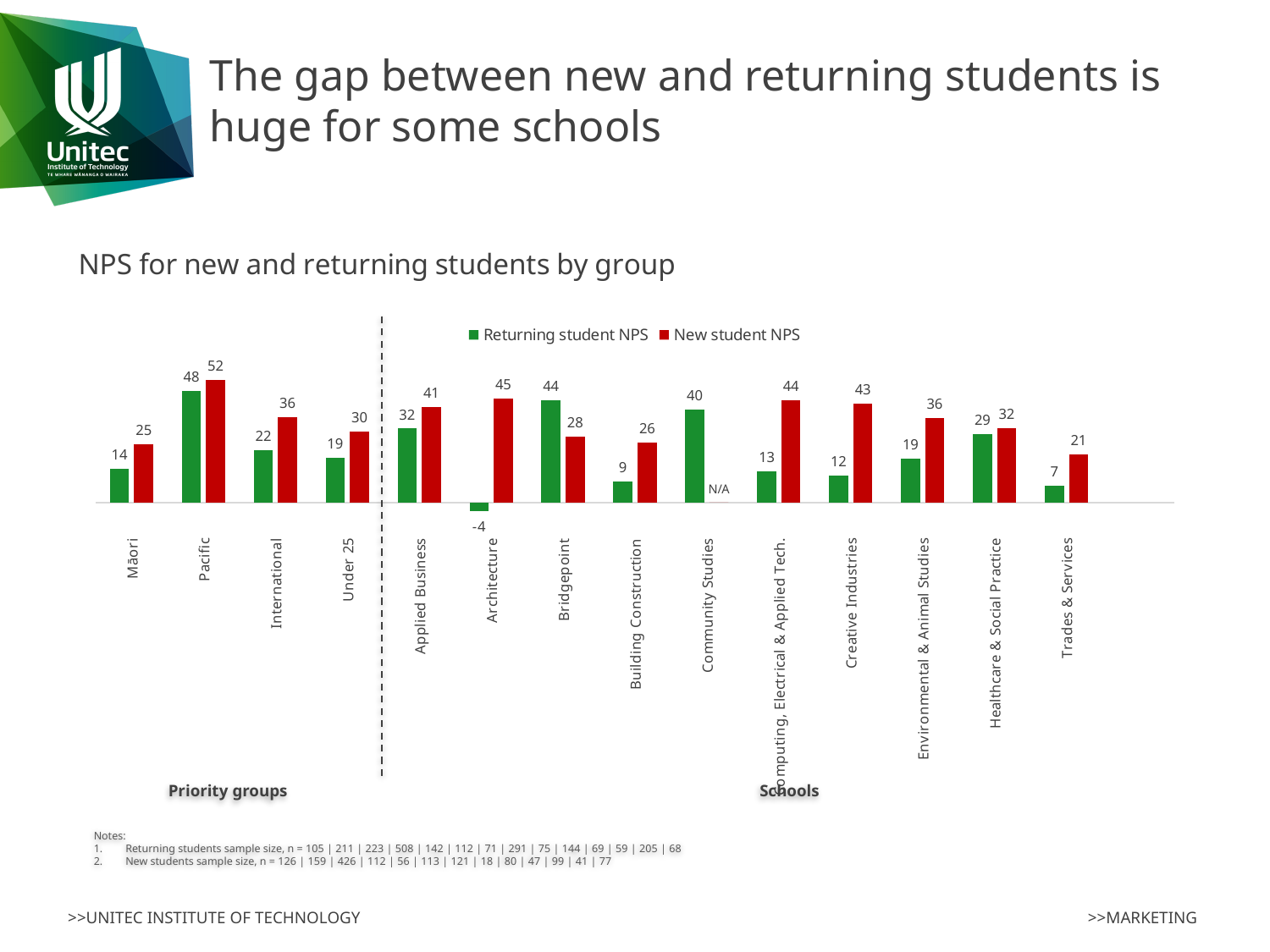
How many series does the legend list? 2 What is the Returning student NPS for Pacific? 48 How many groups are shown on the x axis of the chart? 14 Which group has the highest New student NPS? Pacific Which group has the lowest Returning student NPS? Architecture What is shown for the New student NPS of Community Studies? N/A What is the New student NPS for Architecture? 45 What is the difference between the New student NPS and the Returning student NPS for Creative Industries? 31 What kind of chart is shown on the slide? Bar chart Which colour represents the New student NPS series? Red What is the Returning student NPS for Building Construction? 9 Which is larger for Bridgepoint: the Returning student NPS or the New student NPS? Returning student NPS